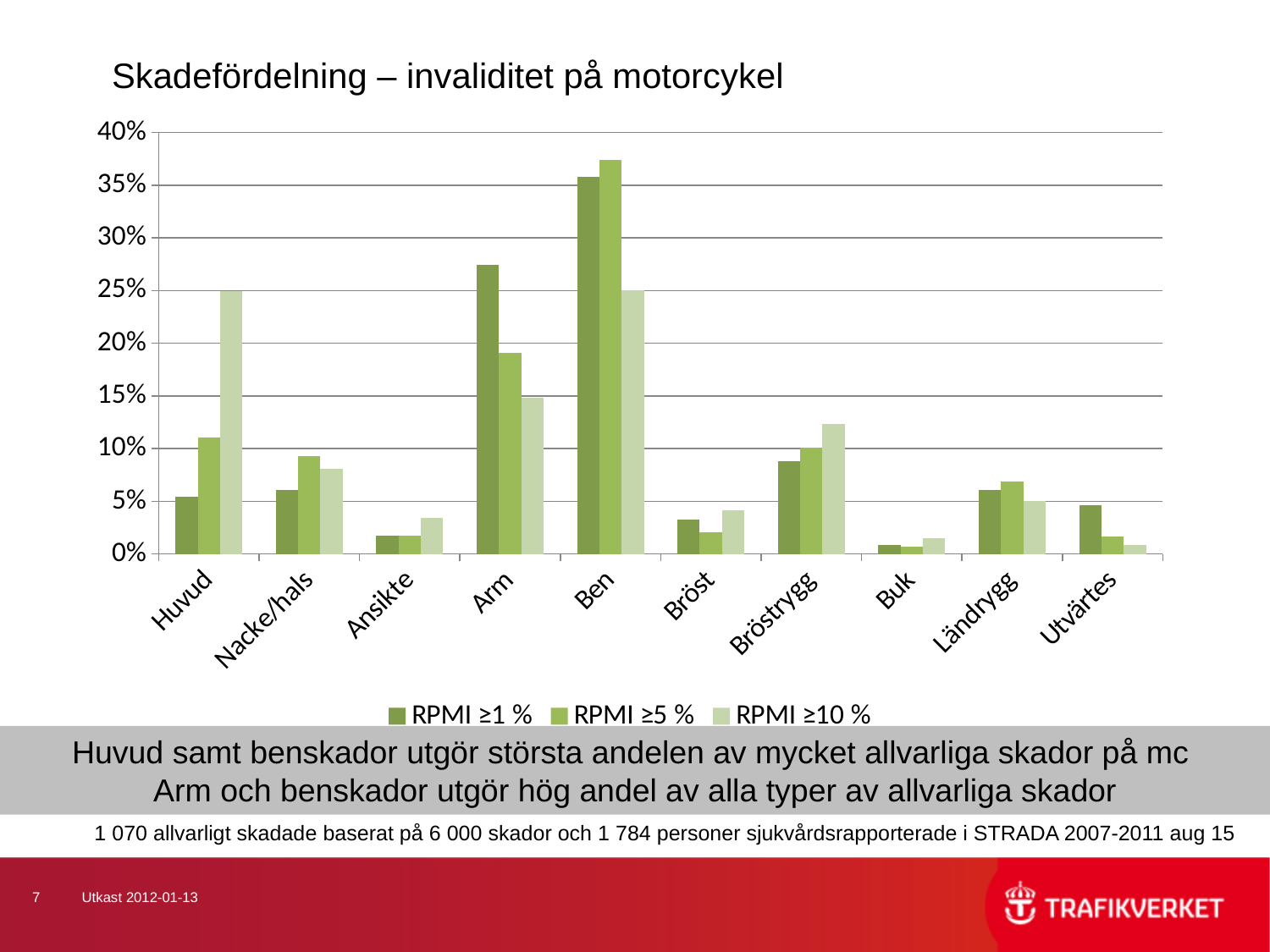
Which category has the highest value for the RPMI ≥1 % series? Ben Is the value for Huvud in the RPMI ≥1 % series greater or less than 10%? less How many series does the legend list? 3 Which category has the lowest value for the RPMI ≥1 % series? Buk For Huvud, which series has the larger value: RPMI ≥1 % or RPMI ≥10 %? RPMI ≥10 % What is the title of the chart? Skadefördelning – invaliditet på motorcykel What kind of chart is shown on the slide? Bar chart Is the value for Bröstrygg in the RPMI ≥10 % series greater or less than 10%? greater Is the value for Ben in the RPMI ≥5 % series greater or less than 35%? greater How many injury categories are shown on the x axis? 10 For the RPMI ≥1 % series, which is larger: Arm or Ben? Ben